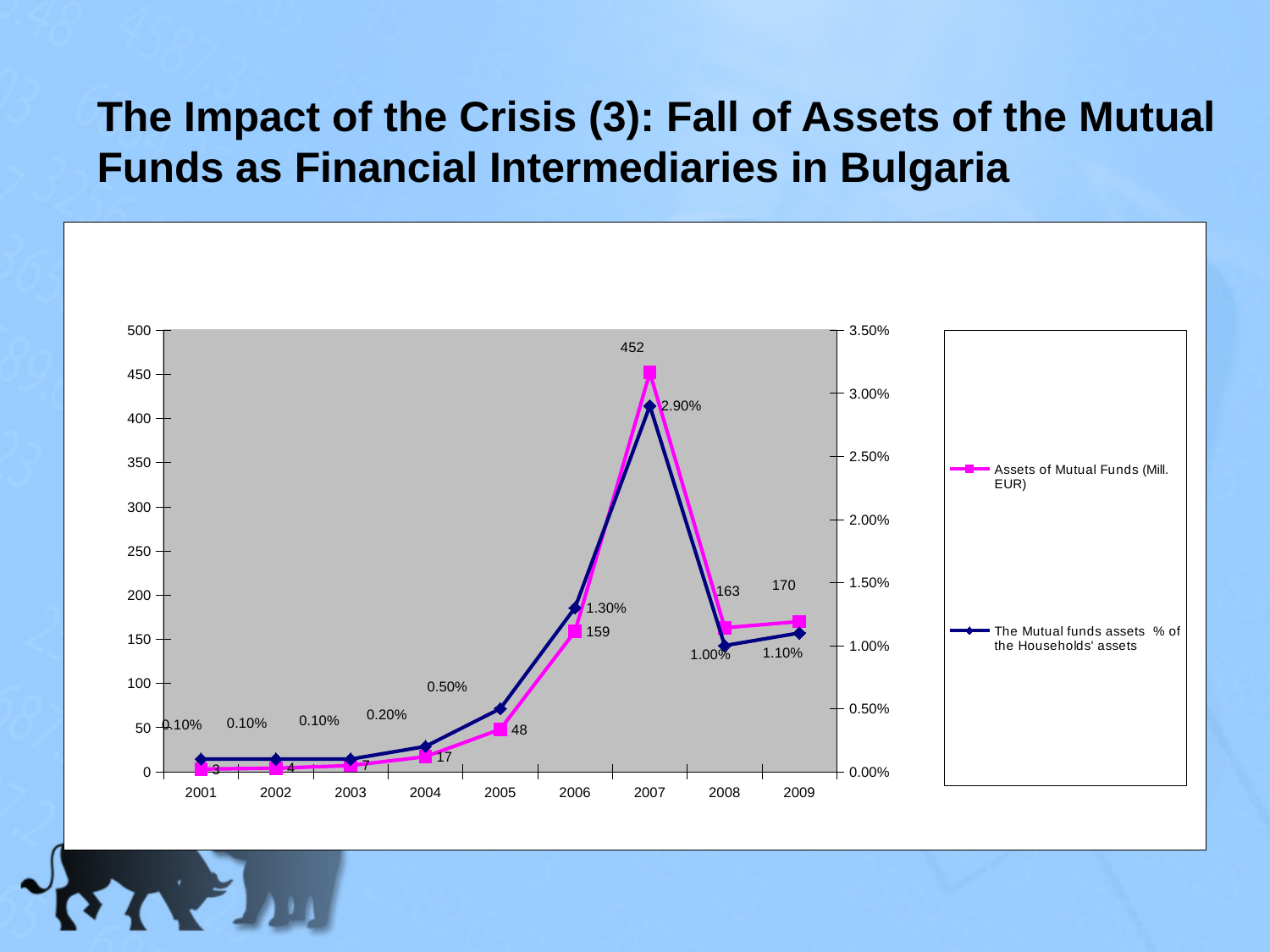
How many series does the legend list? 2 Do the Assets of Mutual Funds (Mill. EUR) rise or fall from 2001 to 2007? rise In which year are the Assets of Mutual Funds (Mill. EUR) highest? 2007 How many years are shown on the x axis of the chart? 9 What is the Mutual funds assets % of the Households' assets in 2006? 1.30% Which year has the larger value of Assets of Mutual Funds (Mill. EUR), 2006 or 2008? 2008 What kind of chart is shown on the slide? line chart In which year are the Assets of Mutual Funds (Mill. EUR) lowest? 2001 What is the value of Assets of Mutual Funds (Mill. EUR) in 2007? 452 What is the difference between the Assets of Mutual Funds (Mill. EUR) in 2007 and in 2008? 289 What is the value of Assets of Mutual Funds (Mill. EUR) in 2009? 170 What is the Mutual funds assets % of the Households' assets in 2008? 1.00%